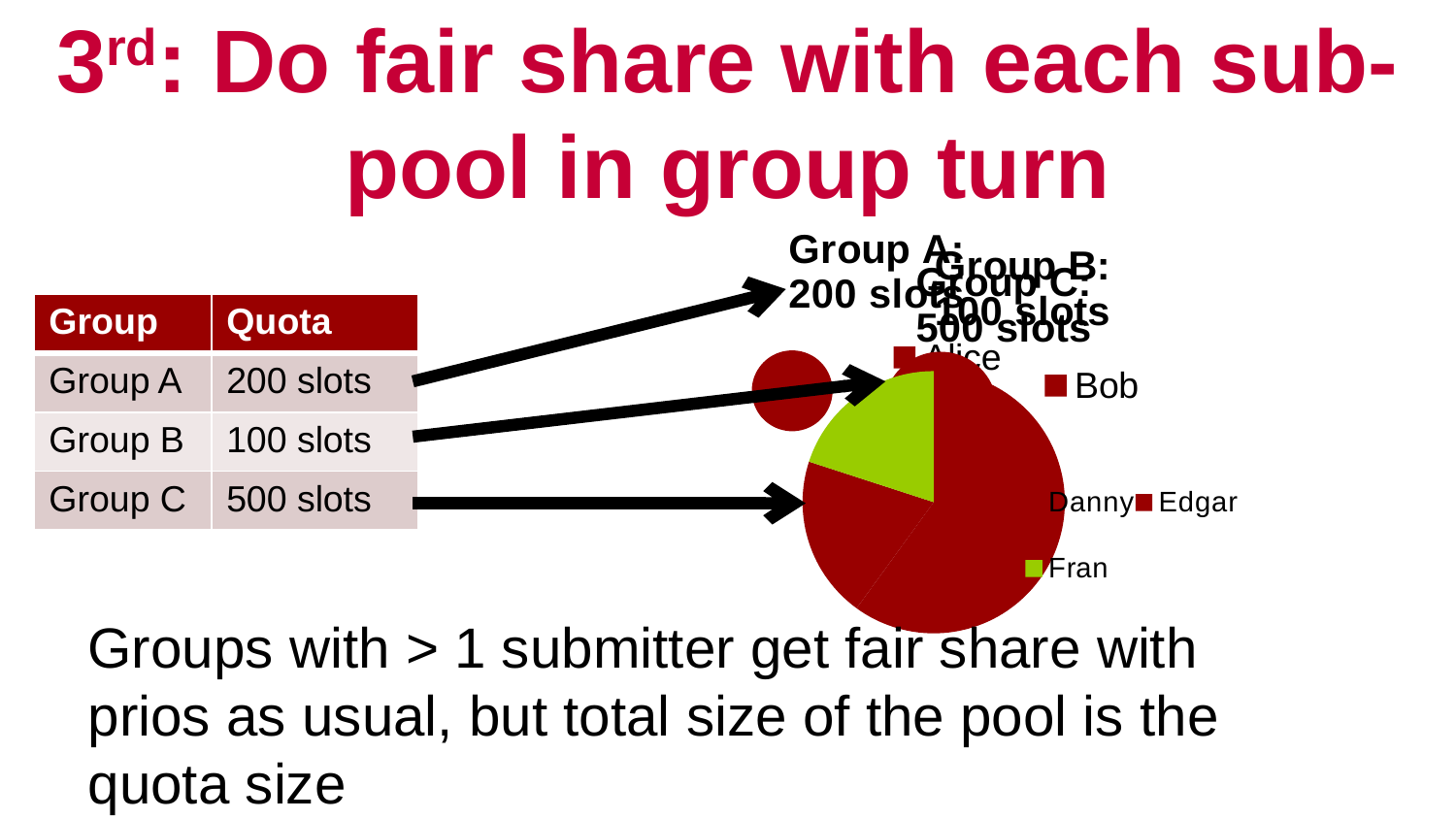
In the large pie chart, is the green slice larger or smaller than the dark red portion? smaller In the large pie chart, which legend entry is shown in green? Fran In the large pie chart, does the green slice take up more or less than half of the pie? less How many names appear in the legend entries next to the pie charts? 5 Which group label above the pie charts shows 500 slots? Group C What kind of chart is shown on the right side of the slide? pie chart